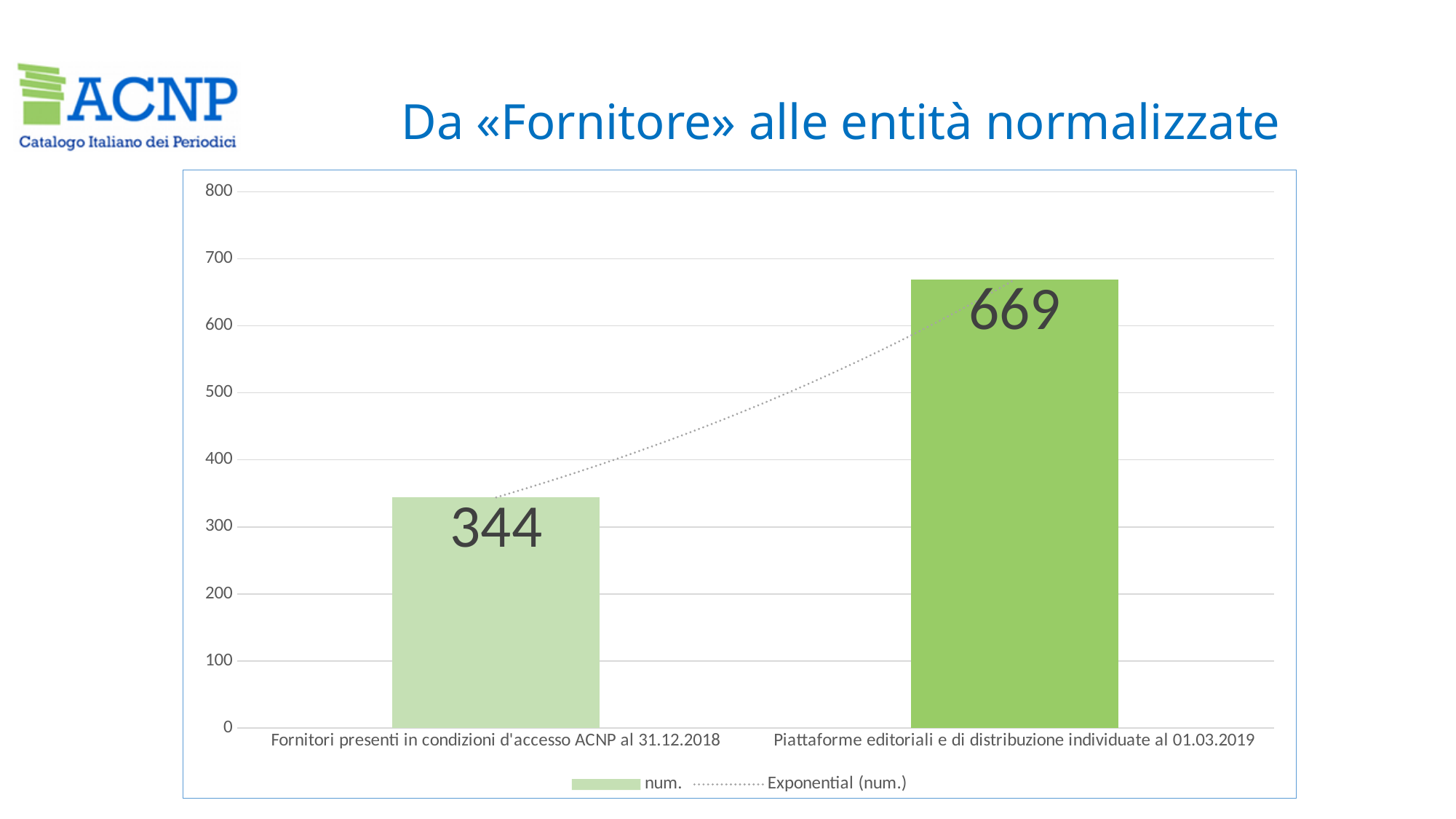
What is the value for 'Fornitori presenti in condizioni d'accesso ACNP al 31.12.2018'? 344 What is the name of the dotted trendline entry in the legend? Exponential (num.) How many categories are shown on the x axis of the chart? 2 Which is larger: the value for 'Fornitori presenti in condizioni d'accesso ACNP al 31.12.2018' or the value for 'Piattaforme editoriali e di distribuzione individuate al 01.03.2019'? Piattaforme editoriali e di distribuzione individuate al 01.03.2019 Which category has the highest value? Piattaforme editoriali e di distribuzione individuate al 01.03.2019 What is the difference between the value for 'Piattaforme editoriali e di distribuzione individuate al 01.03.2019' and the value for 'Fornitori presenti in condizioni d'accesso ACNP al 31.12.2018'? 325 Which category has the lowest value? Fornitori presenti in condizioni d'accesso ACNP al 31.12.2018 What is the value for 'Piattaforme editoriali e di distribuzione individuate al 01.03.2019'? 669 Is the value for 'Fornitori presenti in condizioni d'accesso ACNP al 31.12.2018' greater or less than 400? less Is the value for 'Piattaforme editoriali e di distribuzione individuate al 01.03.2019' greater or less than 600? greater How many entries does the chart legend list? 2 What kind of chart is shown on the slide? bar chart